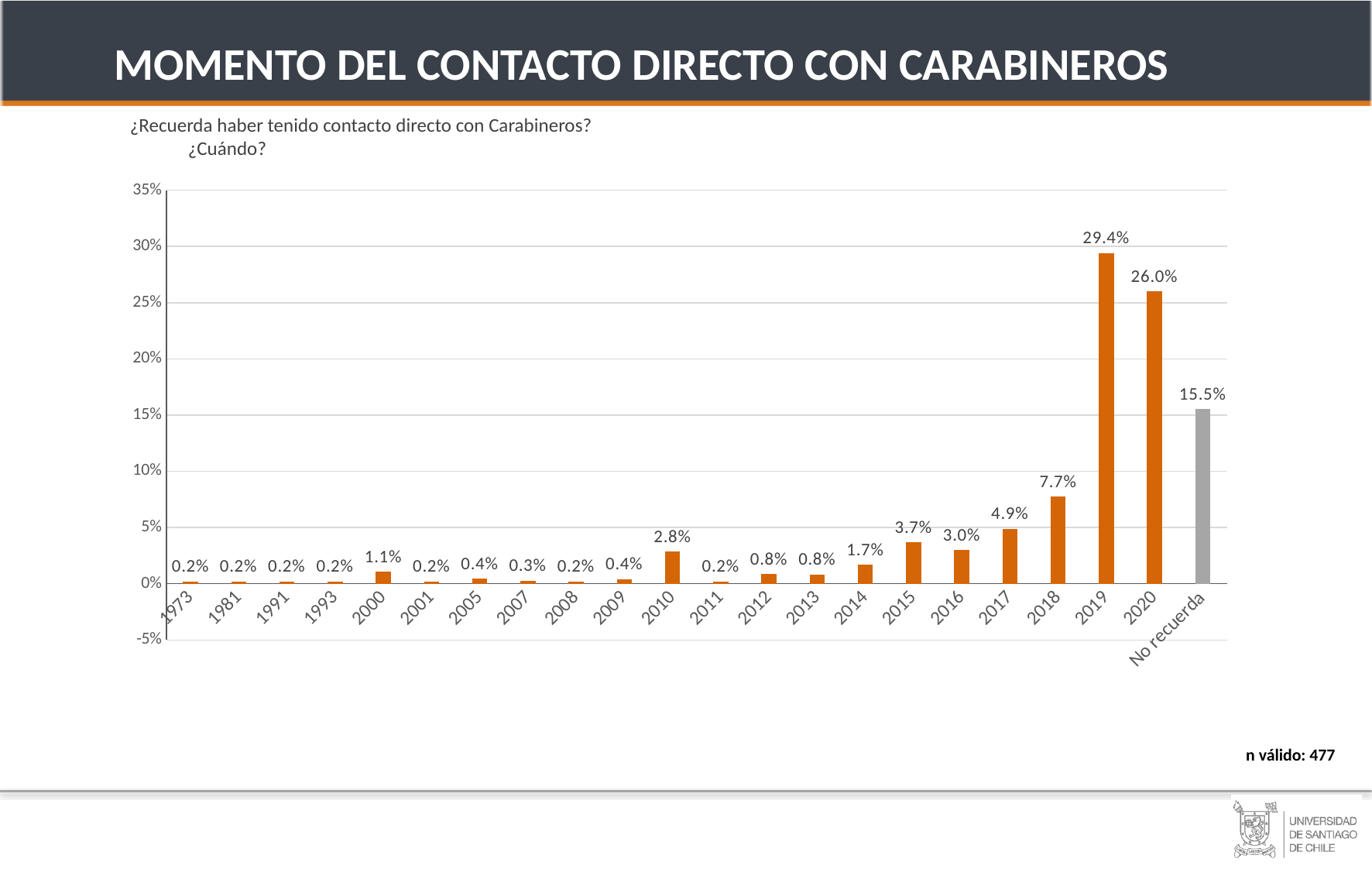
What is the value for 2018? 7.7% Which category has the highest value? 2019 What is the value for 2010? 2.8% What is the value for 2019? 29.4% What is the difference between the values for 2018 and 2017? 2.8% Is the value for 2020 greater or less than 25%? greater What is the valid n reported on the slide? 477 How many categories are shown on the x axis? 22 Which is larger, the value for 2015 or the value for 2016? 2015 What kind of chart is shown on the slide? bar chart What is the value for the 'No recuerda' category? 15.5% What is the difference between the values for 2019 and 2020? 3.4%